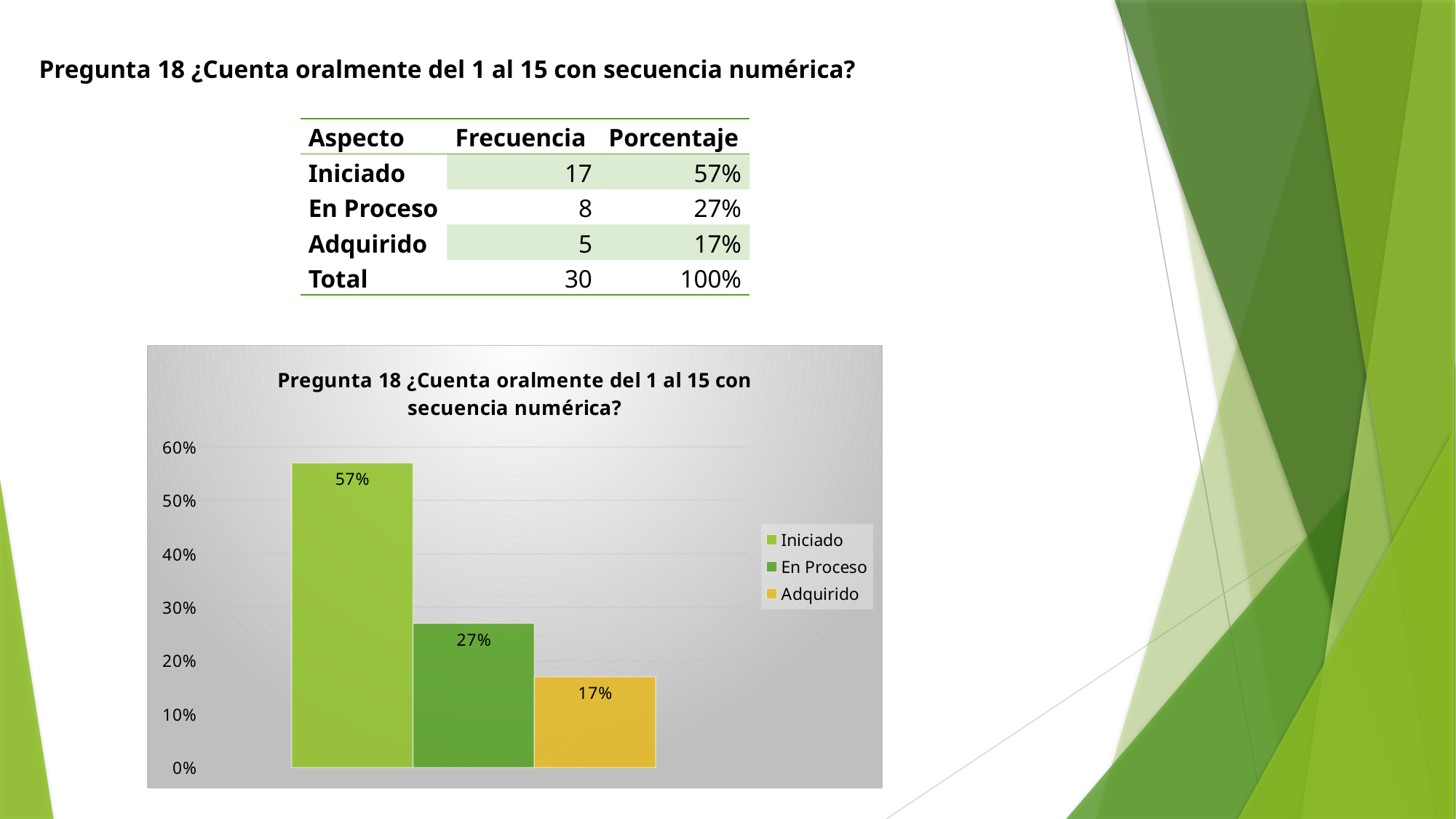
How many bars are plotted in the chart? 3 Which category has the lowest value in the chart? Adquirido What is the value shown for En Proceso in the chart? 27% Which category has the highest value in the chart? Iniciado What is the difference between the values for Iniciado and En Proceso? 30% What kind of chart is shown on the slide? Bar chart Which is larger, the value for En Proceso or the value for Adquirido? En Proceso How many entries does the chart legend list? 3 What is the value shown for Iniciado in the chart? 57% Is the value for Iniciado greater or less than 50%? greater What is the difference between the values for En Proceso and Adquirido? 10% What is the value shown for Adquirido in the chart? 17%